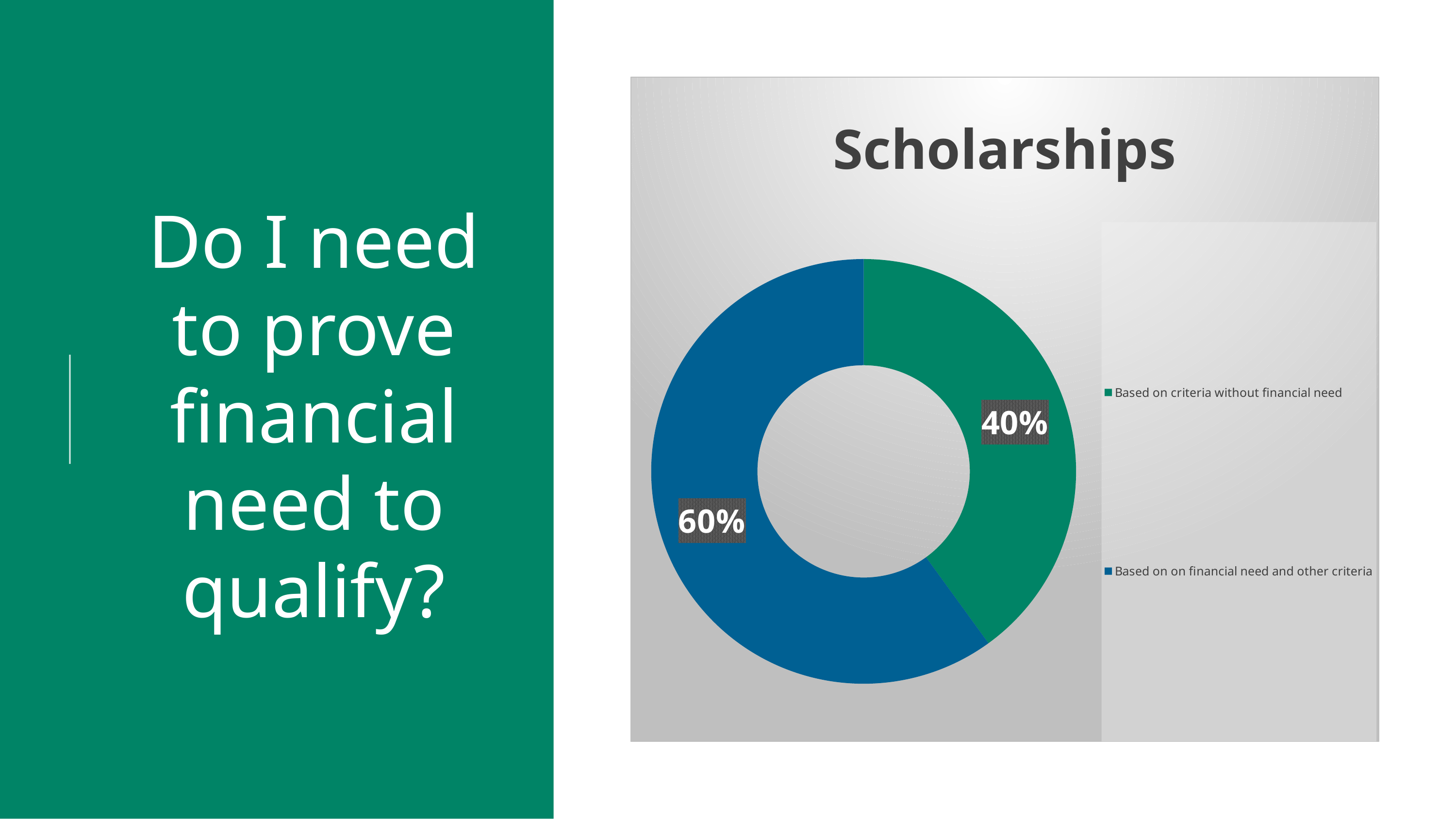
How many entries does the legend list? 2 What percentage of scholarships are based on criteria without financial need? 40% Which is larger: the share based on criteria without financial need or the share based on financial need and other criteria? Based on on financial need and other criteria Which category has the largest share of the chart? Based on on financial need and other criteria What is the difference in percentage points between the two categories? 20 How many categories does the chart show? 2 Is the share for scholarships based on criteria without financial need greater or less than 50%? less Which category has the smallest share of the chart? Based on criteria without financial need What is the title of the chart? Scholarships What colour represents scholarships based on financial need and other criteria? Blue What percentage of scholarships are based on financial need and other criteria? 60% What kind of chart is shown on the slide? Doughnut chart